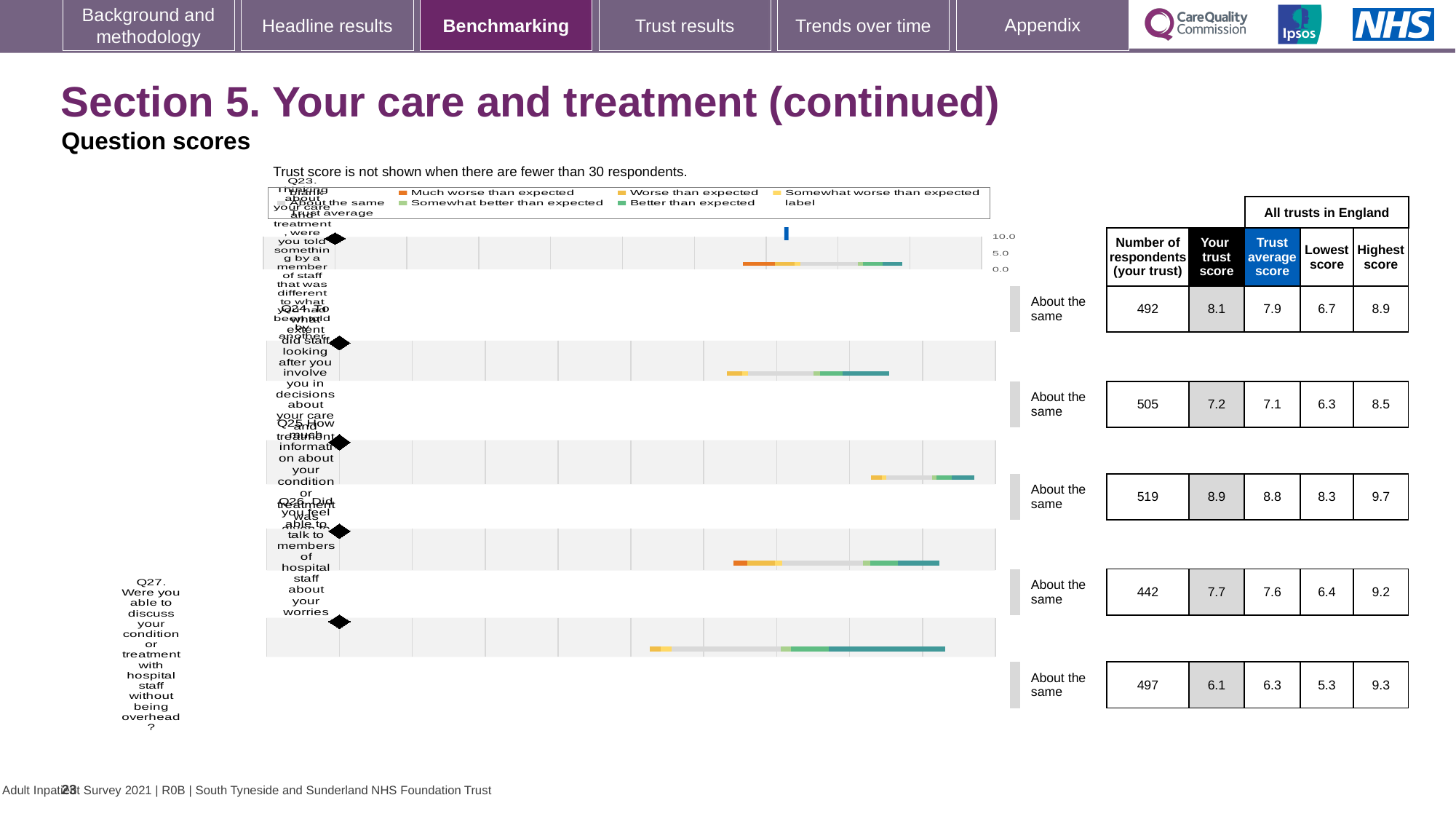
What is the trust average score for Q24 (did staff involve you in decisions about your care and treatment)? 7.1 What is the difference between the 'Your trust score' and the trust average score for Q23? 0.2 What is the 'Your trust score' for Q27 (able to discuss your condition or treatment without being overheard)? 6.1 What is the number of respondents for Q25 (how much information about your condition or treatment was given)? 519 What is the 'Your trust score' for Q23 (being told something by a member of staff that was different to what you had been told by another)? 8.1 How many questions (Q23 to Q27) are plotted in the chart? 5 What kind of chart is used to show the question scores on this slide? bar chart Which question has the highest 'Your trust score'? Q25 For Q27, which is larger: the 'Your trust score' or the trust average score? Trust average score What benchmark category is shown for Q26 (able to talk to members of hospital staff about your worries)? About the same What is the highest score among all trusts in England for Q25? 9.7 Which question has the lowest 'Your trust score'? Q27